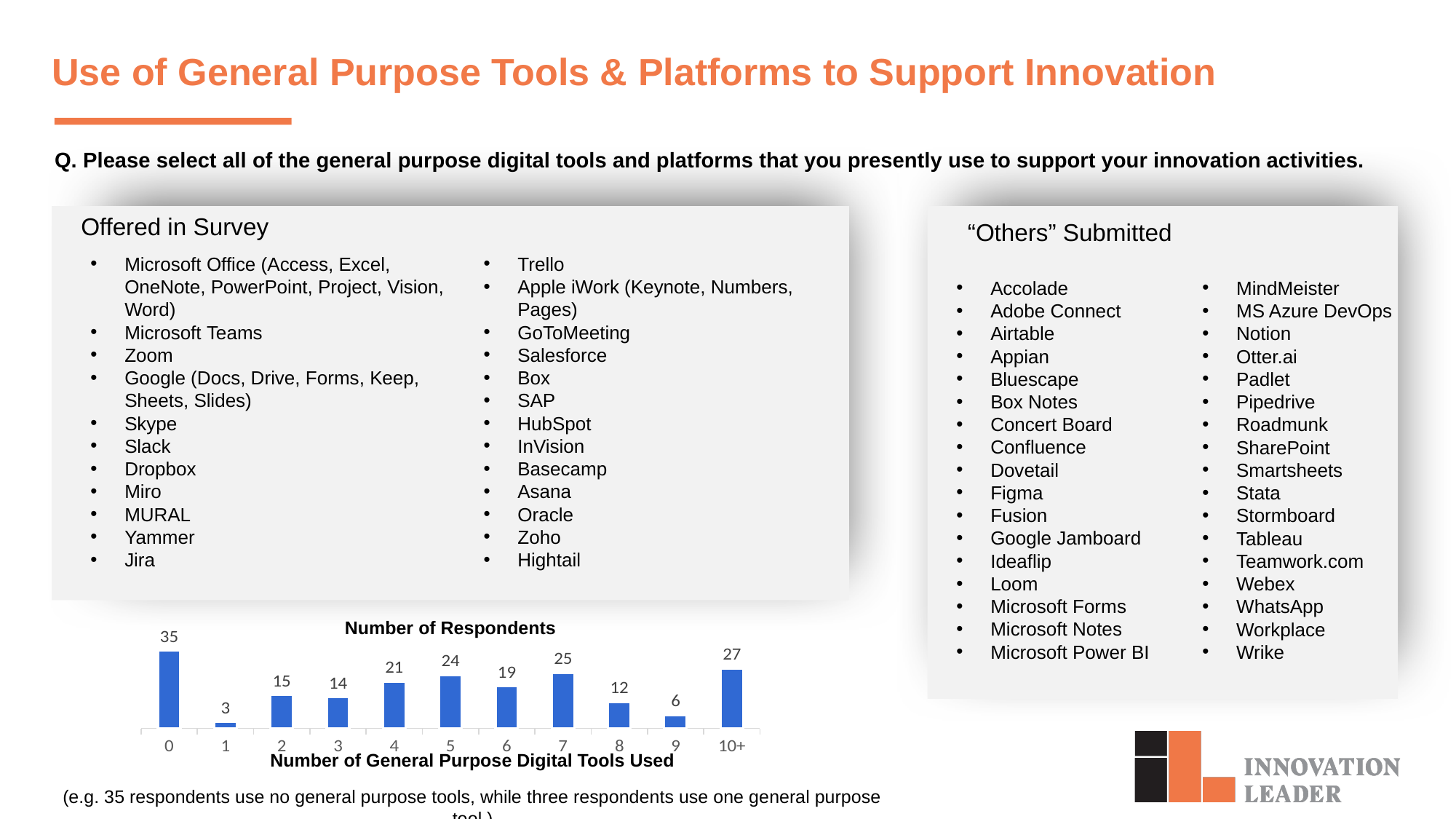
What is the title of the chart? Number of Respondents How many categories are shown on the x axis of the chart? 11 How many respondents use 10+ general purpose digital tools? 27 What is the number of respondents for 7 tools used? 25 Which has more respondents: 5 tools used or 6 tools used? 5 What is the x-axis label of the chart? Number of General Purpose Digital Tools Used What is the difference in respondents between 0 tools used and 10+ tools used? 8 Which number of tools used has the lowest number of respondents? 1 What kind of chart is shown on the slide? Bar chart Which number of tools used has the highest number of respondents? 0 What is the difference in respondents between 8 tools used and 9 tools used? 6 What is the number of respondents who use 0 general purpose digital tools? 35